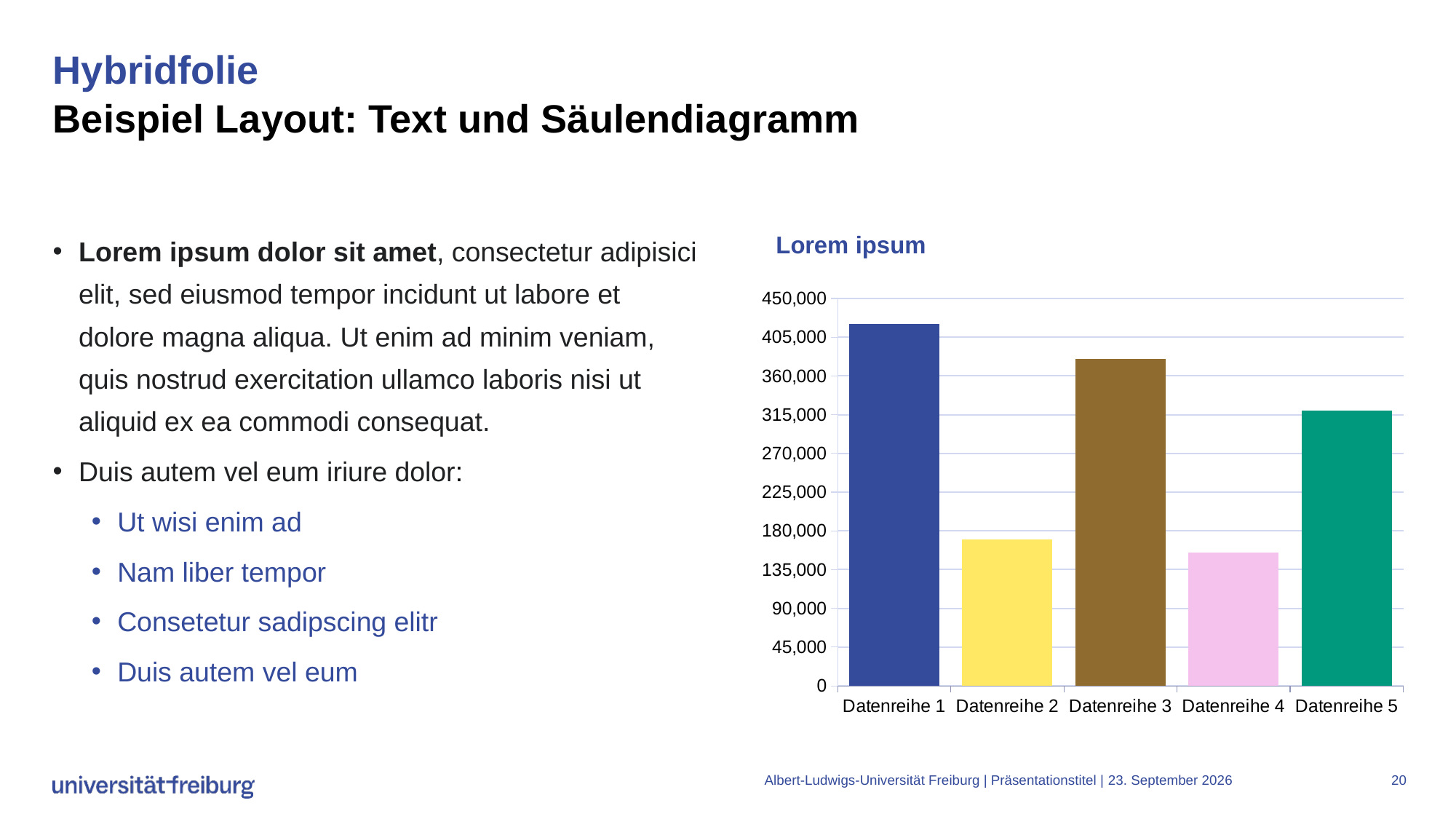
Is the value for Datenreihe 5 greater or less than 270,000? greater What colour is the bar for Datenreihe 5? green What kind of chart is shown on the slide? bar chart Which is larger, the value for Datenreihe 3 or the value for Datenreihe 5? Datenreihe 3 How many categories are plotted in the chart? 5 What is the title of the chart? Lorem ipsum Is the value for Datenreihe 1 greater or less than 405,000? greater Which category has the highest value in the chart? Datenreihe 1 Which is larger, the value for Datenreihe 2 or the value for Datenreihe 4? Datenreihe 2 Is the value for Datenreihe 2 greater or less than 180,000? less Which category has the lowest value in the chart? Datenreihe 4